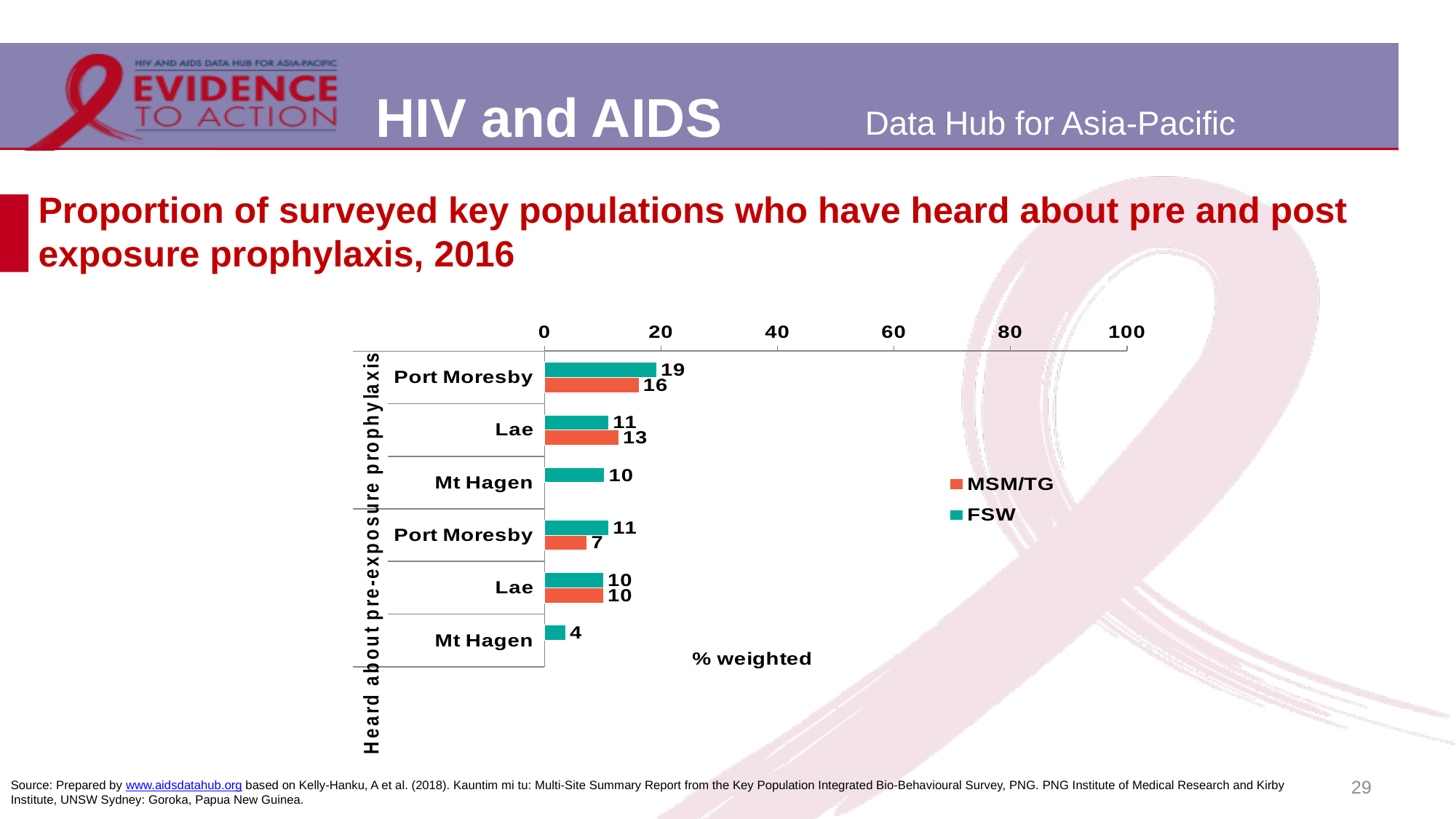
Which bar in the chart has the lowest value? FSW for Mt Hagen in the lower group (4) In the lower group of bars, what is the MSM/TG value for Port Moresby? 7 In the upper group of bars, what is the FSW value for Port Moresby? 19 How many series does the chart legend list? 2 What is the label on the horizontal axis of the chart? % weighted In the upper group of bars, what is the difference between the FSW and MSM/TG values for Port Moresby? 3 Which two series are listed in the chart legend? MSM/TG and FSW In the upper group of bars, what is the MSM/TG value for Lae? 13 What type of chart is shown on the slide? Bar chart Which bar in the chart has the highest value? FSW for Port Moresby in the upper group (19) In the lower group of bars, what is the FSW value for Mt Hagen? 4 In the lower group of bars, which is larger for Port Moresby: the FSW value or the MSM/TG value? FSW